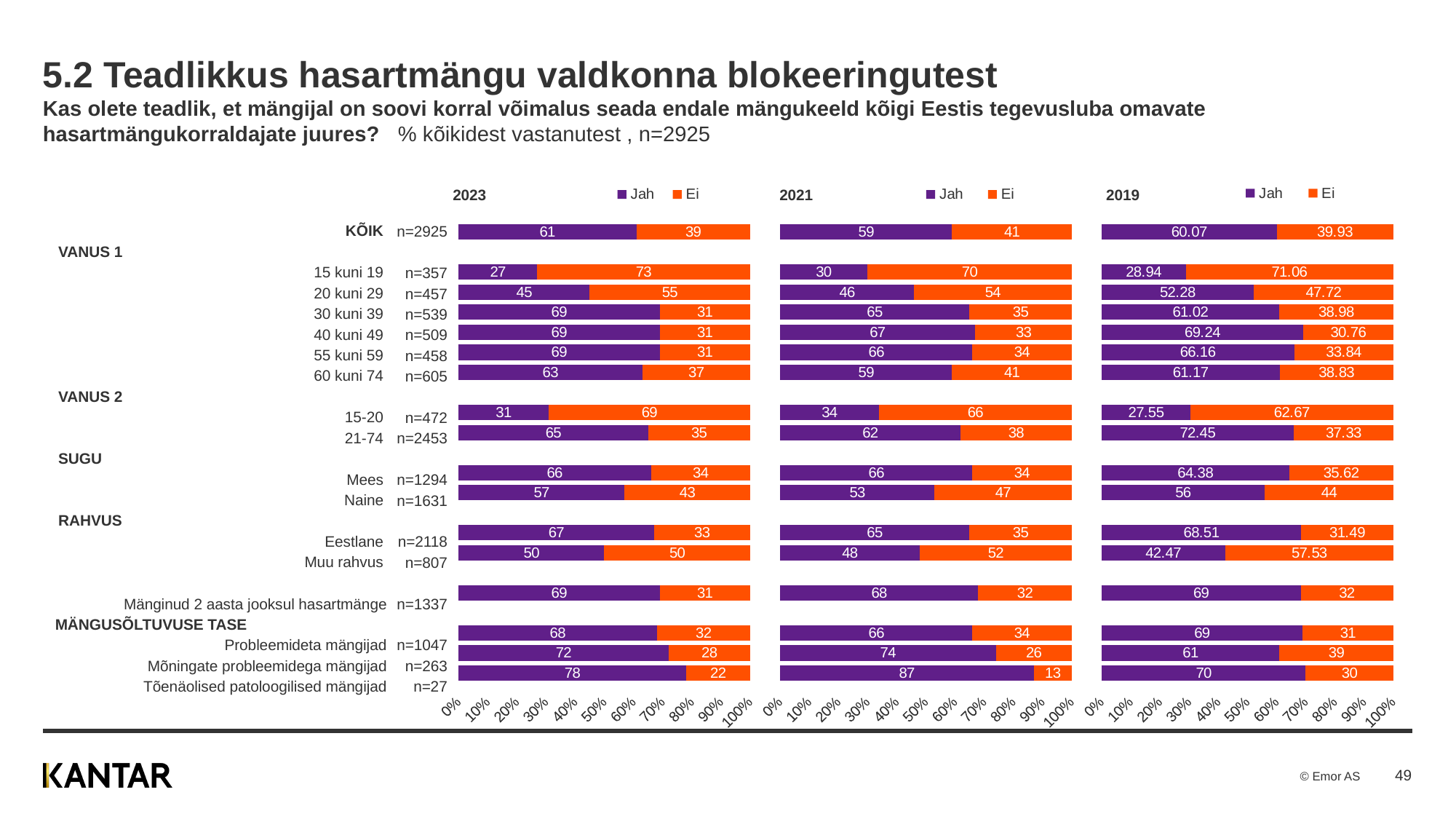
In the 2019 chart, which has the larger Jah value, Eestlane or Muu rahvus? Eestlane What kind of chart is the 2023 chart? Stacked bar chart In the 2021 chart, what is the Ei value for 15 kuni 19? 70 In the 2023 chart, what is the difference between the Jah value for Mees and the Jah value for Naine? 9 How many series does the legend of the 2023 chart list? 2 In the 2021 chart, what is the difference between the Ei value for 15 kuni 19 and the Ei value for 20 kuni 29? 16 In the 2021 chart, which category has the lowest Jah value? 15 kuni 19 In the 2021 chart, what is the Jah value for Tõenäolised patoloogilised mängijad? 87 In the 2023 chart, what colour represents the Jah series? Purple In the 2019 chart, what is the Jah value for 40 kuni 49? 69.24 In the 2023 chart, which category has the highest Jah value? Tõenäolised patoloogilised mängijad In the 2023 chart, what is the Jah value for KÕIK? 61